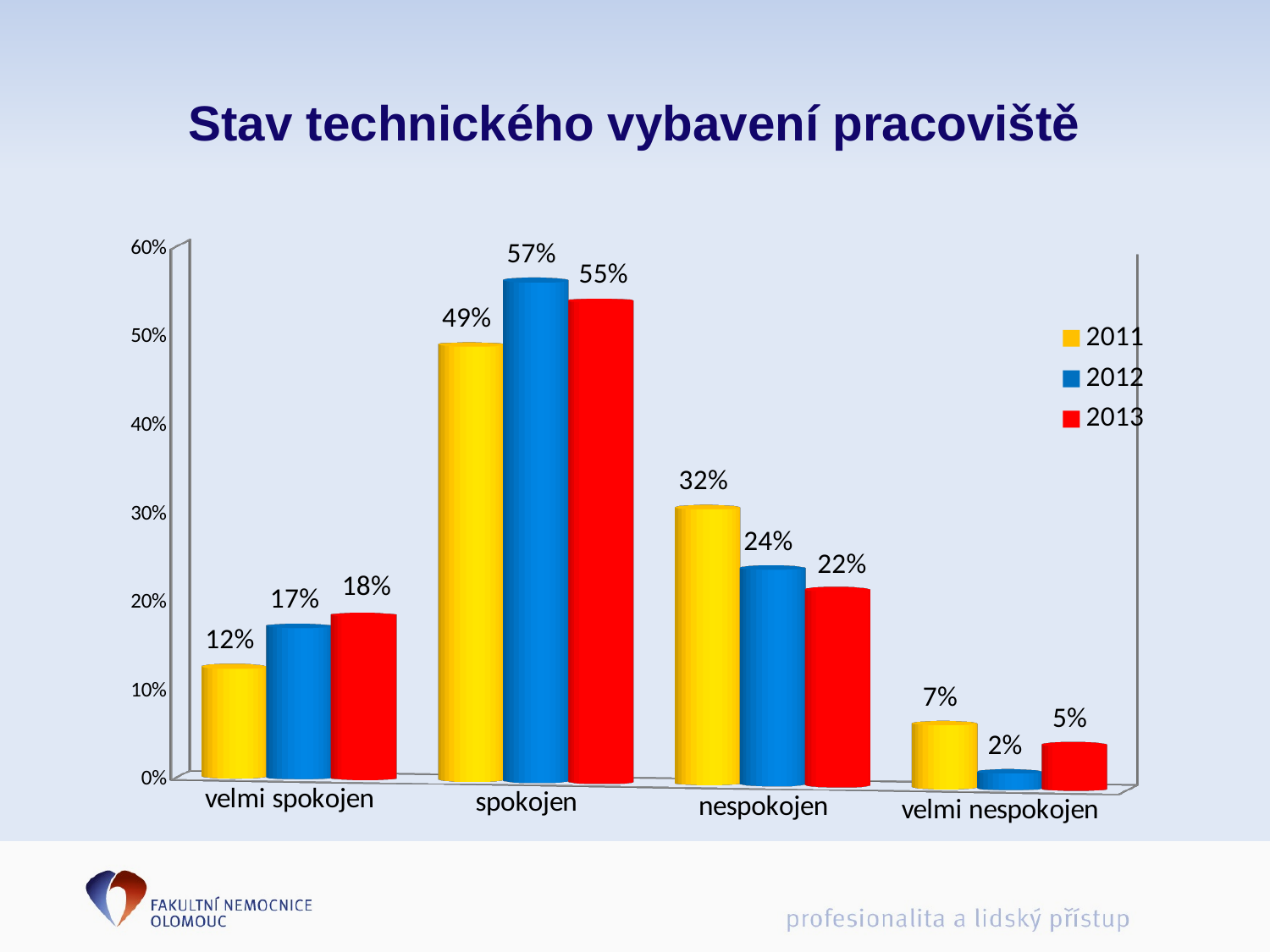
How many categories are shown on the x axis? 4 Which is larger in the "velmi spokojen" category: the 2012 value or the 2013 value? 2013 How many series does the legend list? 3 Which category has the highest value for 2013? spokojen Does the 2011 series rise or fall from "spokojen" to "velmi nespokojen"? fall What is the value for 2011 in the "nespokojen" category? 32% Which category has the lowest value for 2012? velmi nespokojen What is the value for 2012 in the "spokojen" category? 57% What is the title of the chart? Stav technického vybavení pracoviště What is the value for 2013 in the "velmi nespokojen" category? 5% What is the difference between the 2011 and 2013 values in the "nespokojen" category? 10% What kind of chart is shown on the slide? bar chart